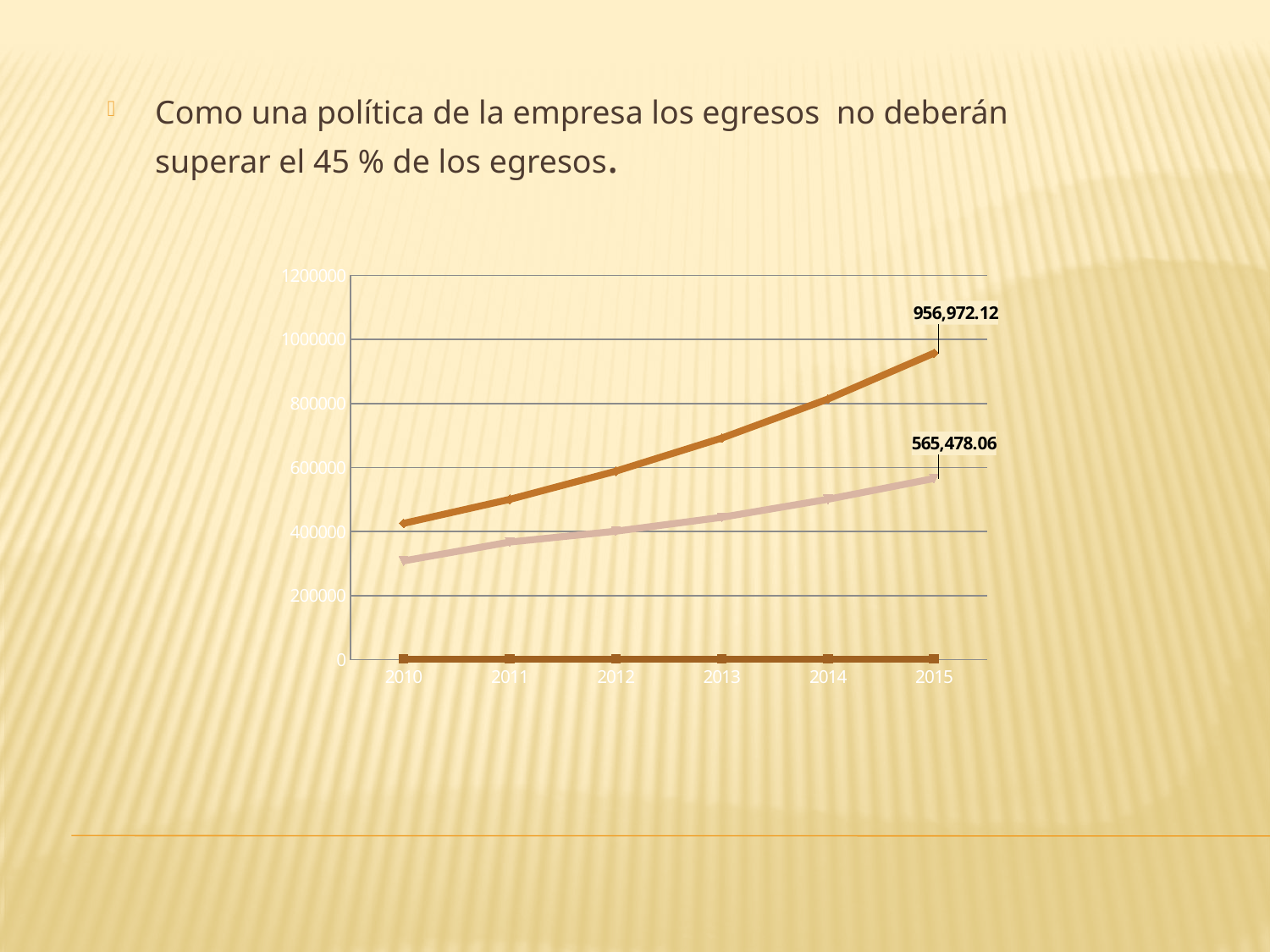
What is the labelled value of the upper (dark orange) line in 2015? 956,972.12 Is the value of the dark orange line in 2010 greater or less than 600000? less What kind of chart is shown on the slide? line chart Is the value of the dark orange line in 2013 greater or less than 600000? greater What is the difference between the two labelled 2015 values, 956,972.12 and 565,478.06? 391,494.06 Is the value of the light pink line in 2010 greater or less than 400000? less In which year does the dark orange line reach its highest value? 2015 What is the labelled value of the lower (light pink) line in 2015? 565,478.06 In 2015, which line has the larger value, the dark orange line or the light pink line? the dark orange line How many years are shown on the x axis of the chart? 6 What is the first year shown on the x axis of the chart? 2010 Does the dark orange line rise or fall from 2010 to 2015? rises